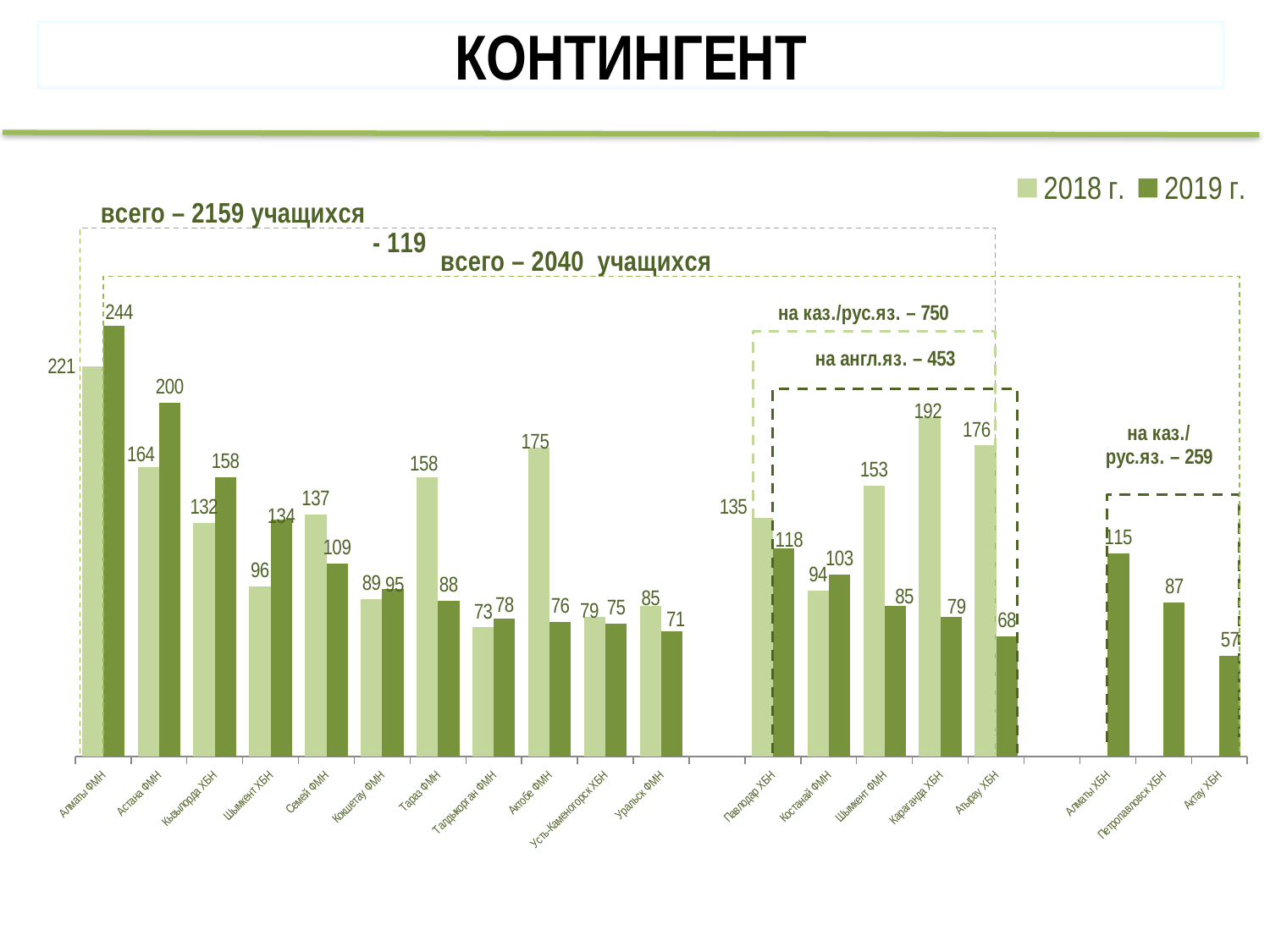
What is the 2019 г. value for Актау ХБН? 57 Which category has the highest 2019 г. value? Алматы ФМН Which is larger for Тараз ФМН, the 2018 г. value or the 2019 г. value? 2018 г. What is the difference between the 2019 г. and 2018 г. values for Астана ФМН? 36 What is the title of the slide? КОНТИНГЕНТ Which category has the lowest 2019 г. value? Актау ХБН What is the 2018 г. value for Актобе ФМН? 175 What is the difference between the 2018 г. and 2019 г. values for Караганда ХБН? 113 What kind of chart is shown on the slide? bar chart What is the 2019 г. value for Алматы ФМН? 244 How many series does the legend list? 2 What total number of students is given for 2019 г. (всего)? 2040 учащихся